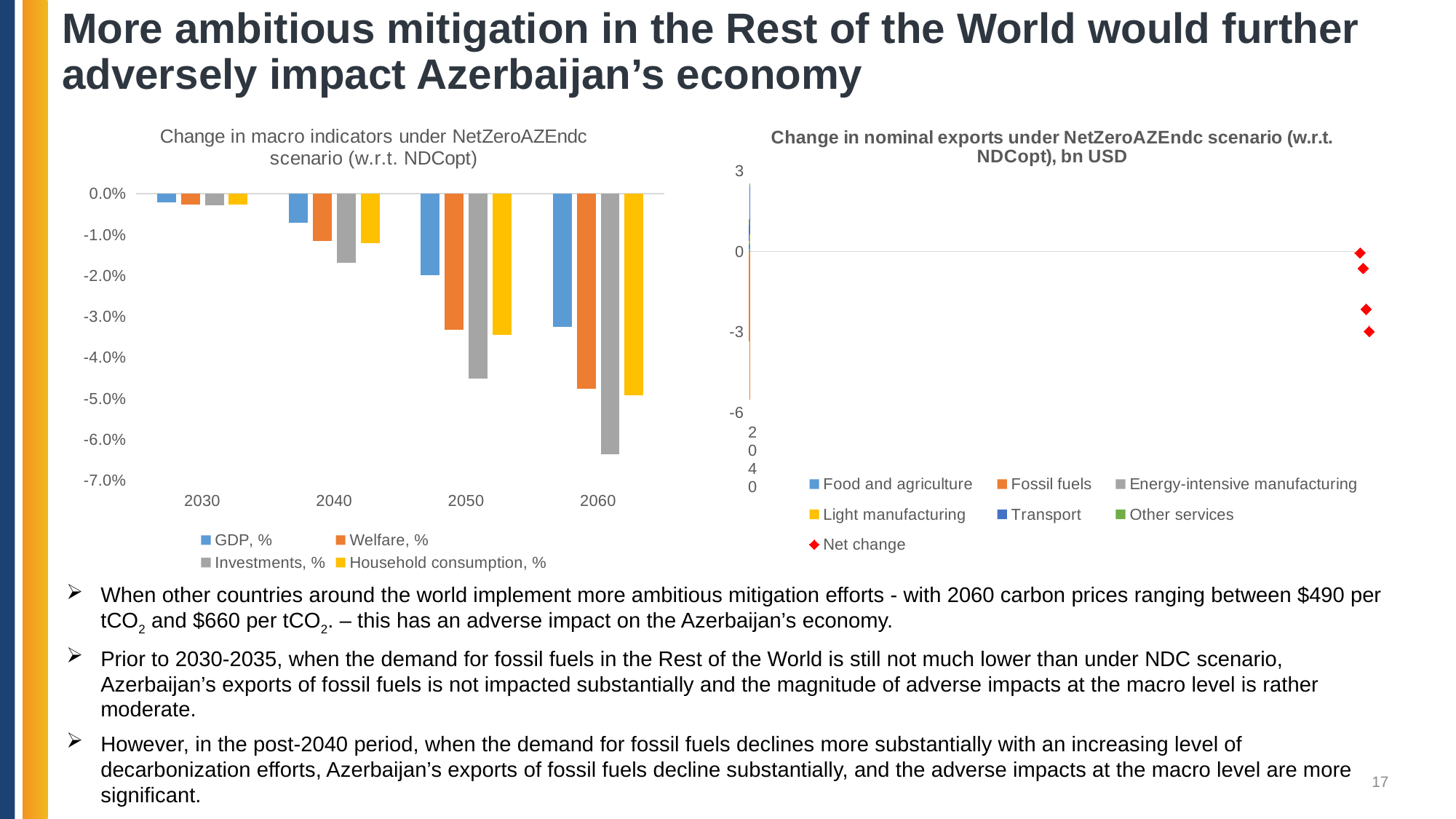
In the left chart on macro indicators, is the Welfare value for 2060 greater or less than -4.0%? less What kind of chart is the left chart, 'Change in macro indicators under NetZeroAZEndc scenario (w.r.t. NDCopt)'? Bar chart In the left chart on macro indicators, how many years are shown on the x axis? 4 In the left chart on macro indicators, is the Investments value for 2050 greater or less than -4.0%? less In the left chart on macro indicators, do the GDP values rise or fall from 2030 to 2060? fall In the left chart on macro indicators, is the GDP value for 2040 greater or less than -1.0%? greater In the left chart on macro indicators, which series has the lowest value in 2060? Investments, % In the right chart on nominal exports, how many entries does the legend list? 7 In the left chart on macro indicators, which is lower in 2050: GDP or Investments? Investments In the left chart on macro indicators, in which year is the Investments value lowest? 2060 In the left chart on macro indicators, how many series does the legend list? 4